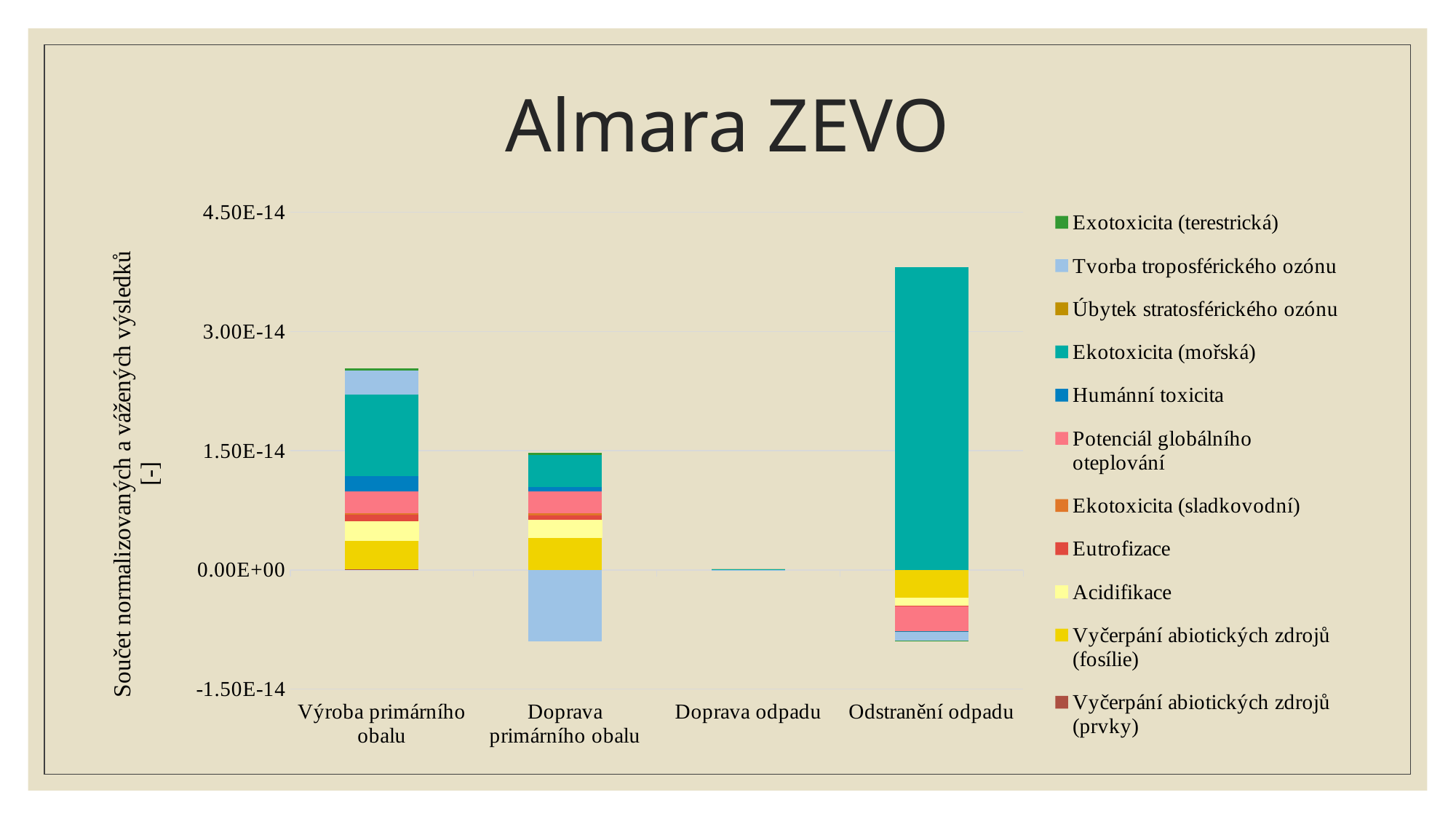
How many categories are shown on the x axis of the chart? 4 Which category has the smallest bar, barely visible above zero? Doprava odpadu Is the top of the positive stack for Odstranění odpadu greater or less than 3.00E-14? greater Which category has the tallest positive stacked bar? Odstranění odpadu Which category has a large negative segment for Tvorba troposférického ozónu? Doprava primárního obalu What is the title of the chart? Almara ZEVO Is the top of the positive stack for Výroba primárního obalu greater or less than 3.00E-14? less Which category has a larger positive stacked bar, Výroba primárního obalu or Doprava primárního obalu? Výroba primárního obalu Is the top of the positive stack for Výroba primárního obalu greater or less than 1.50E-14? greater How many series does the legend of the chart list? 11 What kind of chart is shown on the slide? Stacked bar chart Which series forms the largest segment of the Odstranění odpadu bar? Ekotoxicita (mořská)